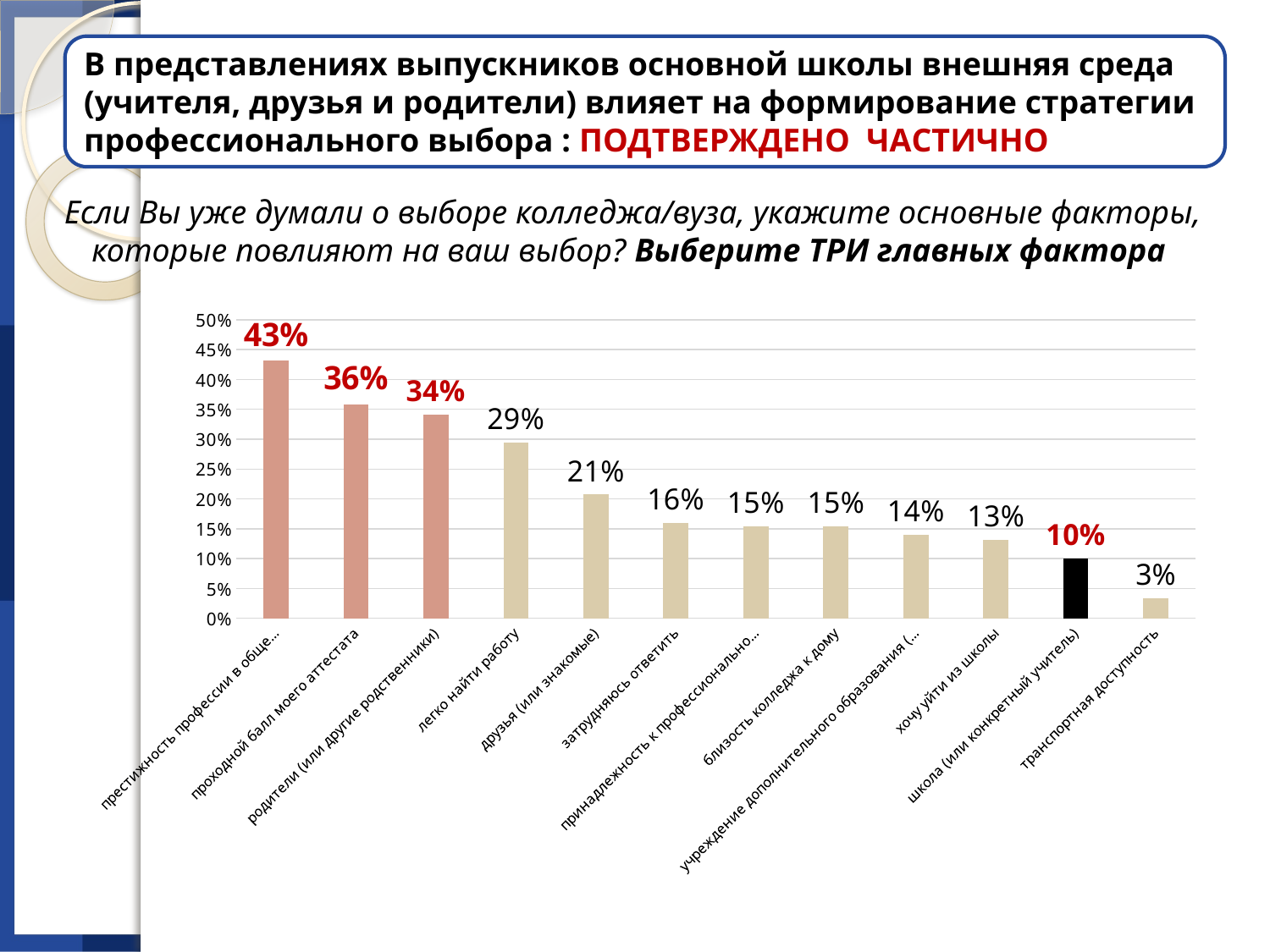
Which is larger: the value for "хочу уйти из школы" or the value for "близость колледжа к дому"? близость колледжа к дому What value is shown for "школа (или конкретный учитель)"? 10% Which category has the highest value? престижность профессии в обще... What is the difference between the values for "друзья (или знакомые)" and "школа (или конкретный учитель)"? 11% What colour is the bar for "школа (или конкретный учитель)"? black What value is shown for "легко найти работу"? 29% Which category has the lowest value? транспортная доступность What value is shown for "родители (или другие родственники)"? 34% How many categories are shown in the chart? 12 What kind of chart is shown on the slide? bar chart What value is shown for "проходной балл моего аттестата"? 36% Do the values rise or fall from left to right along the x axis? fall